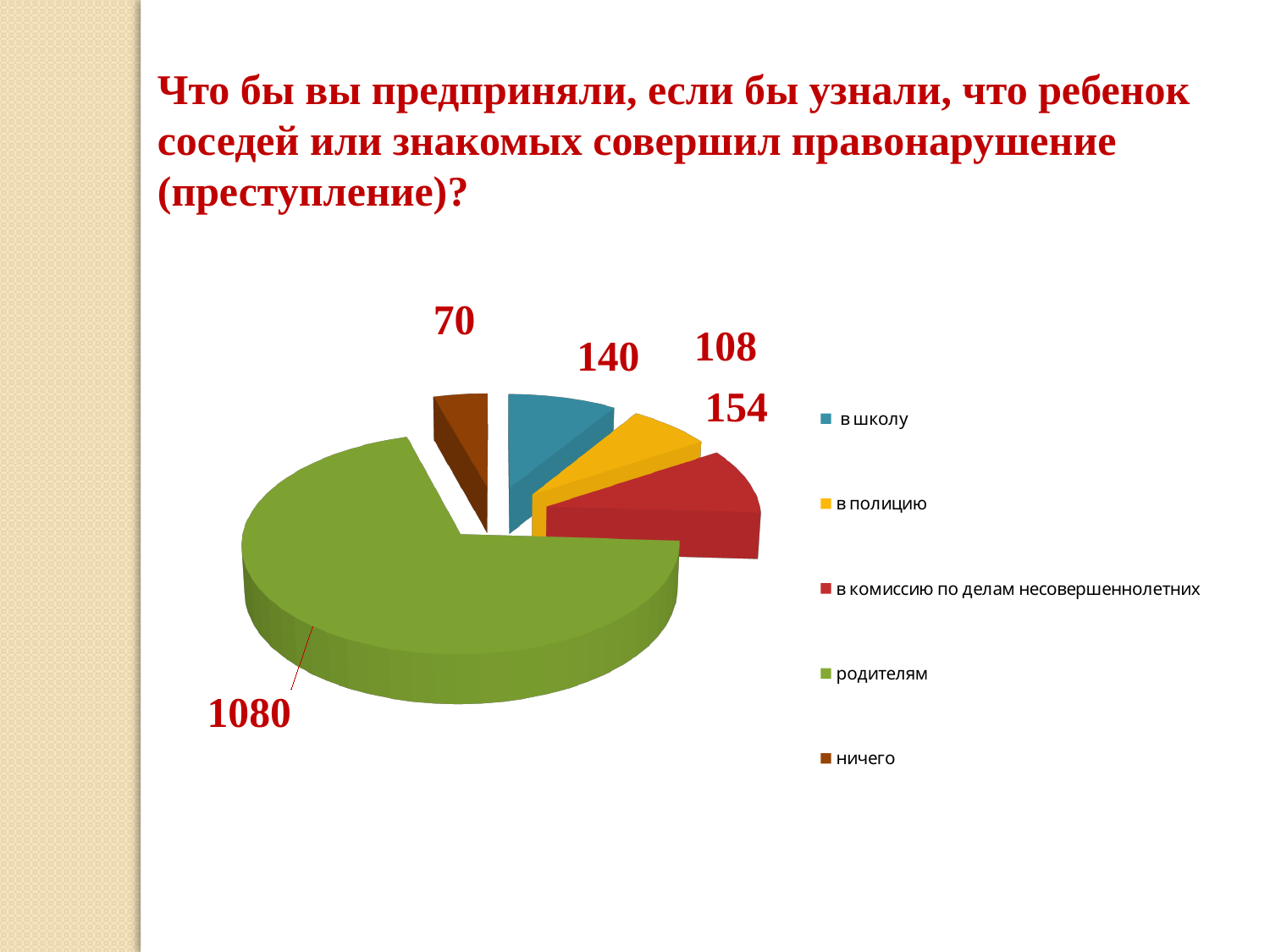
What is the value for "ничего"? 70 What kind of chart is shown on the slide? pie chart What is the value for "родителям"? 1080 Which category has the largest slice? родителям What is the difference between the values for "в комиссию по делам несовершеннолетних" and "в полицию"? 46 What is the value for "в полицию"? 108 What is the value for "в комиссию по делам несовершеннолетних"? 154 How many entries does the legend list? 5 Which category has the smallest slice? ничего How many slices does the pie chart have? 5 What is the value for "в школу"? 140 Which is larger, the value for "в школу" or the value for "в полицию"? в школу